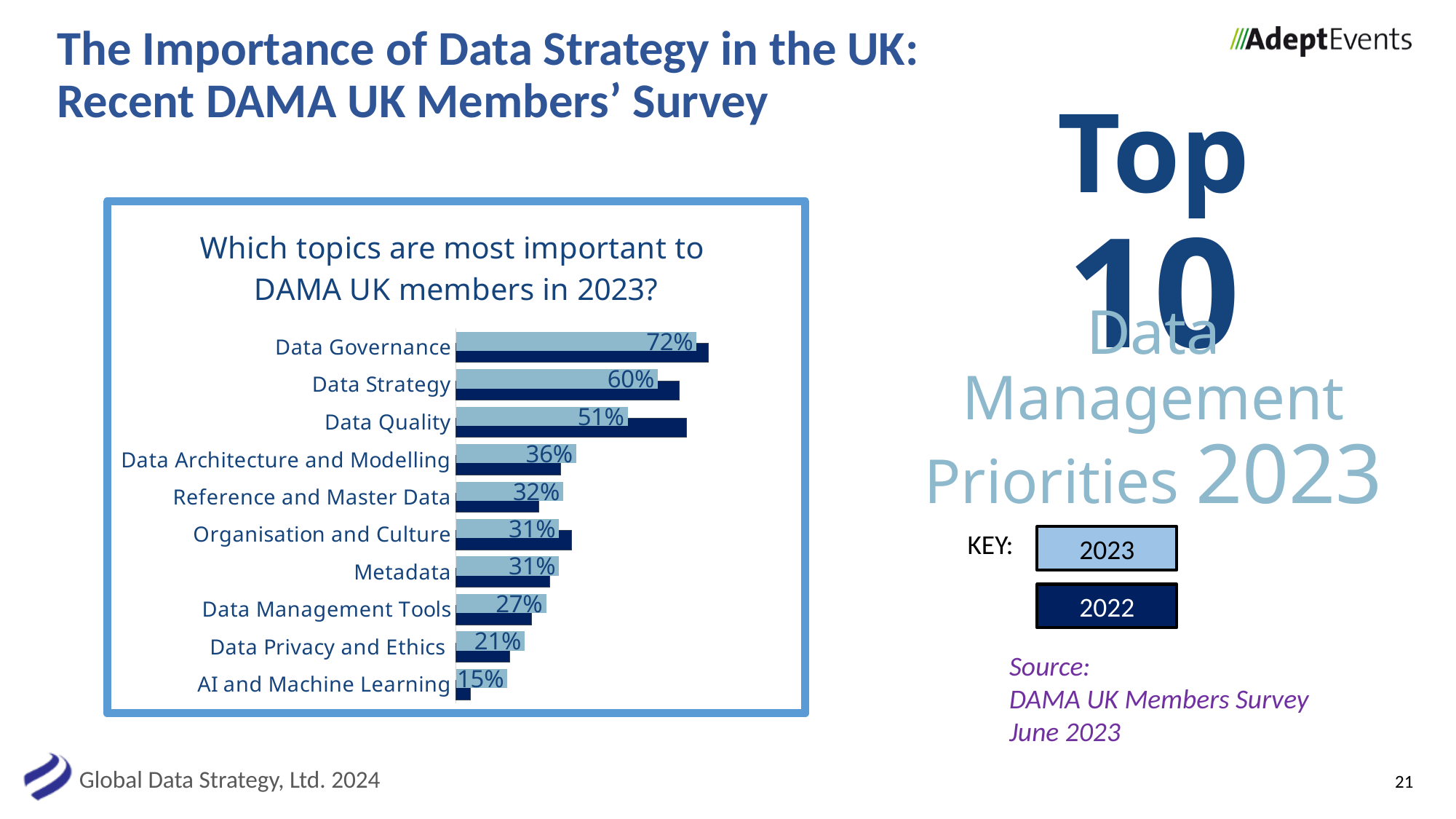
How many topics are listed in the chart? 10 Which topic has the lowest 2023 value? AI and Machine Learning What is the 2023 value for Data Governance? 72% What is the 2023 value for AI and Machine Learning? 15% What kind of chart is shown on the slide? bar chart How many series does the key list? 2 What is the difference between the 2023 values for Data Quality and Data Management Tools? 24% What is the 2023 value for Reference and Master Data? 32% Which topic has the highest 2023 value? Data Governance What is the 2023 value for Data Strategy? 60% What is the difference between the 2023 values for Data Governance and Data Strategy? 12% For Data Quality, which year's bar is longer, 2022 or 2023? 2022